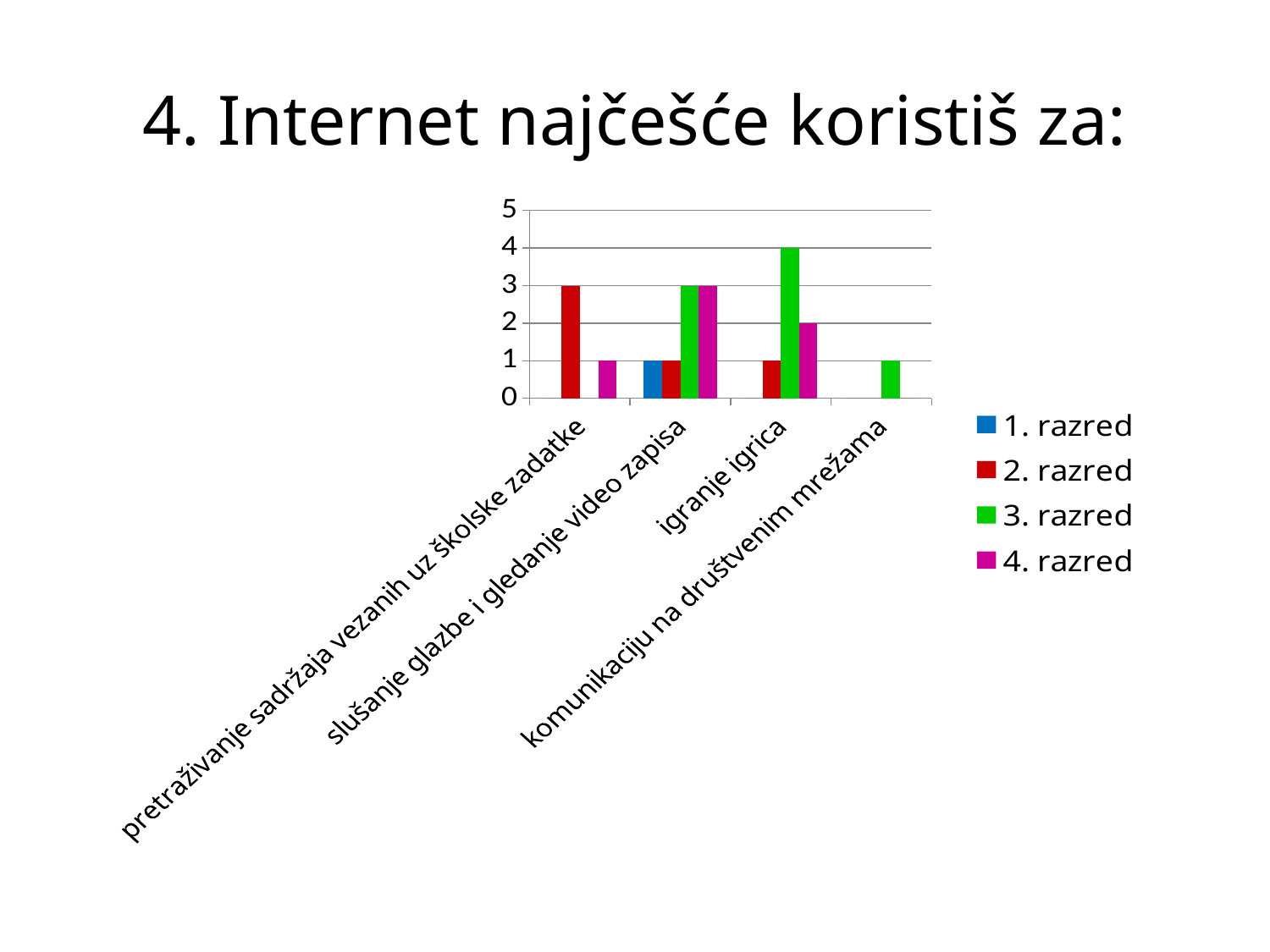
How many series does the chart's legend list? 4 What is the value for 4. razred in the category 'igranje igrica'? 2 How many categories are shown on the x axis of the chart? 4 What is the value for 3. razred in the category 'igranje igrica'? 4 What is the title of the slide containing the chart? 4. Internet najčešće koristiš za: Which category has the highest value for 3. razred? igranje igrica In the category 'slušanje glazbe i gledanje video zapisa', which is larger: the value for 3. razred or the value for 1. razred? 3. razred What is the value for 2. razred in the category 'pretraživanje sadržaja vezanih uz školske zadatke'? 3 Which category has the highest value for 2. razred? pretraživanje sadržaja vezanih uz školske zadatke What is the difference between the 3. razred and 4. razred values in the category 'igranje igrica'? 2 What kind of chart is shown on the slide? bar chart What is the value for 3. razred in the category 'komunikaciju na društvenim mrežama'? 1